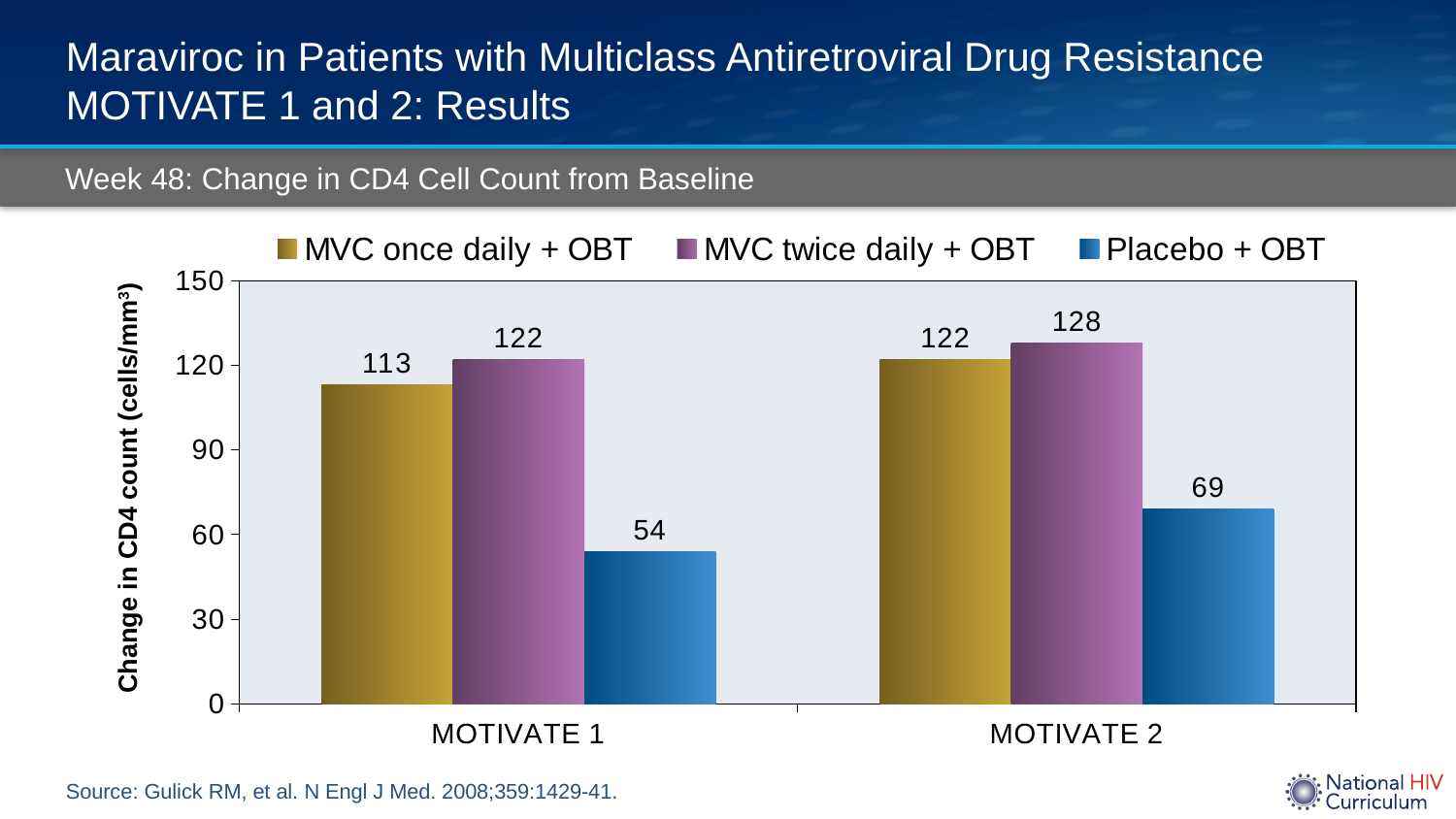
How many series does the legend list? 3 Is the value for Placebo + OBT in MOTIVATE 1 greater or less than 60? less What is the difference in CD4 count change between MVC twice daily + OBT and Placebo + OBT in MOTIVATE 1? 68 Which treatment arm has the lowest change in CD4 count in MOTIVATE 1? Placebo + OBT Which is larger: the change in CD4 count for MVC once daily + OBT in MOTIVATE 1 or in MOTIVATE 2? MOTIVATE 2 What is the difference in CD4 count change for Placebo + OBT between MOTIVATE 2 and MOTIVATE 1? 15 What is the change in CD4 count for MVC once daily + OBT in MOTIVATE 1? 113 What is the change in CD4 count for MVC twice daily + OBT in MOTIVATE 2? 128 What is the change in CD4 count for Placebo + OBT in MOTIVATE 2? 69 Which treatment arm has the highest change in CD4 count in MOTIVATE 2? MVC twice daily + OBT How many study groups are shown on the x axis? 2 What kind of chart is shown on the slide? Bar chart